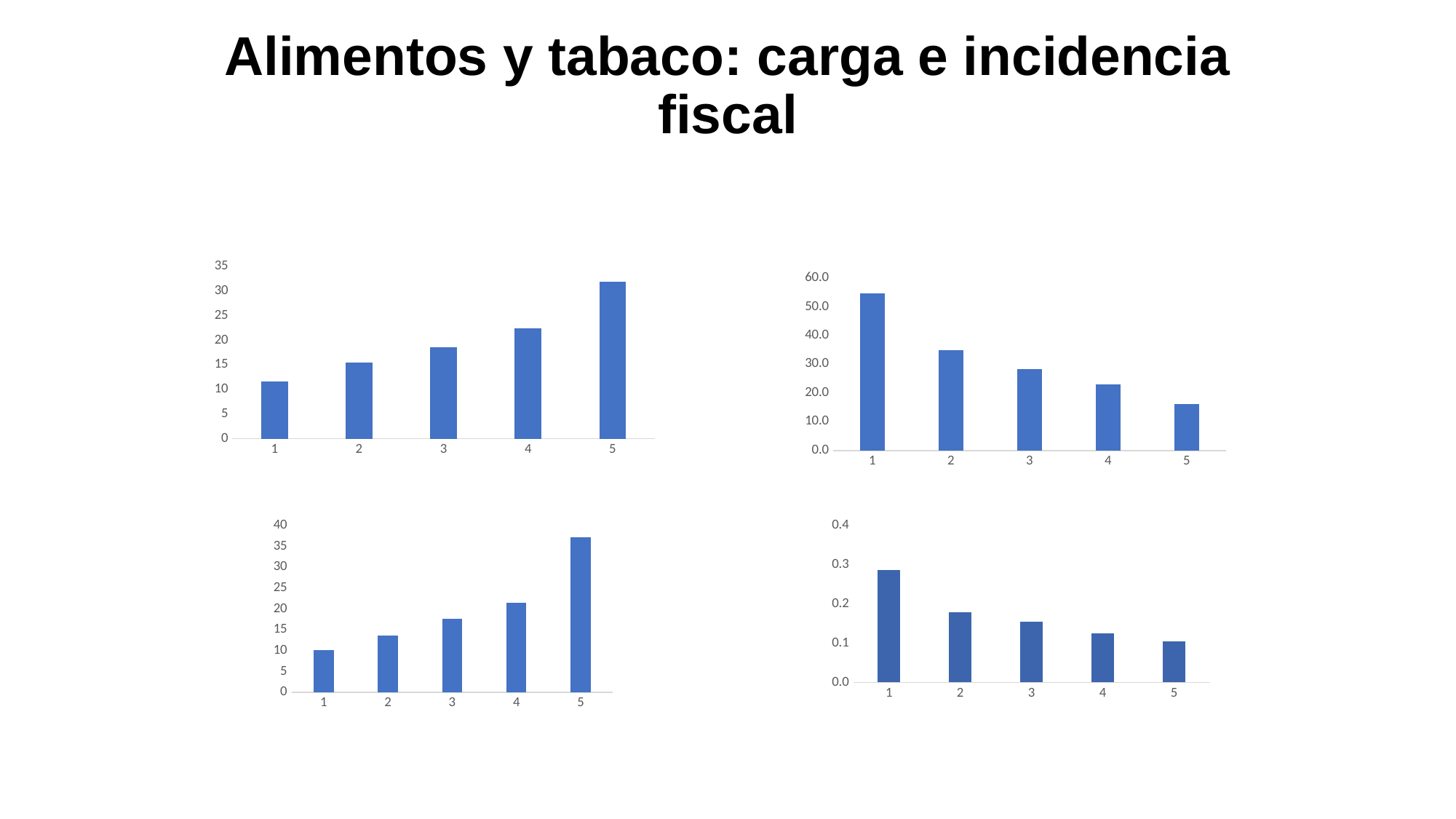
In the top-left chart, is the value for category 5 greater or less than 30? greater In the top-left chart, do the values rise or fall from category 1 to category 5? rise In the bottom-right chart, which category has the lowest bar? 5 In the top-left chart, which category has the lowest bar? 1 In the top-left chart, which category has the highest bar? 5 In the top-right chart, do the values rise or fall from category 1 to category 5? fall In the top-right chart, is the value for category 1 greater or less than 50.0? greater In the top-right chart, which category has the highest bar? 1 What kind of chart is the bottom-right chart? bar chart In the bottom-left chart, is the value for category 5 greater or less than 35? greater In the bottom-left chart, how many bars are plotted? 5